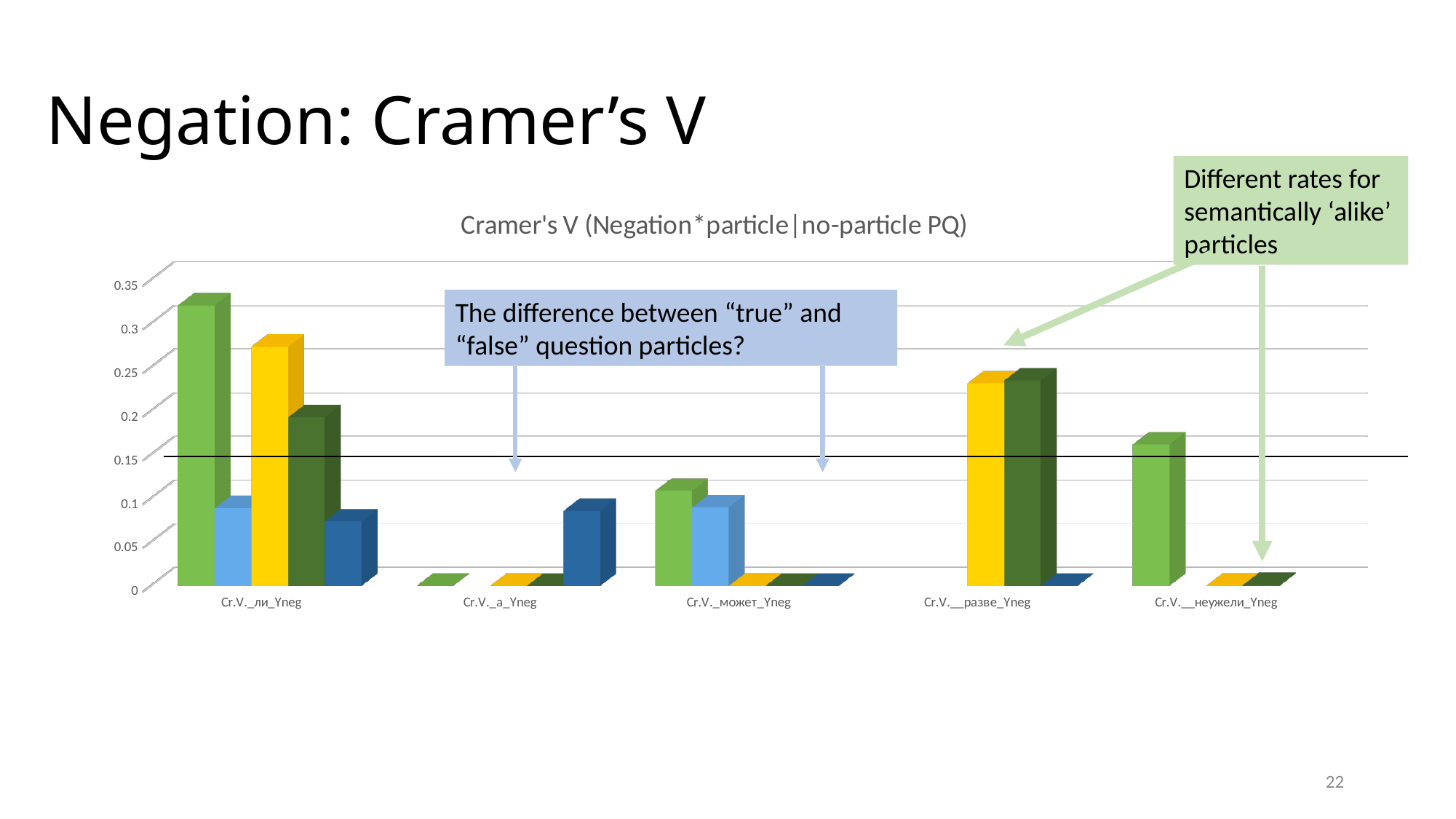
How many categories are shown along the x axis of the chart? 5 What is the highest tick value shown on the vertical axis of the chart? 0.35 What is the title of the chart? Cramer's V (Negation*particle|no-particle PQ) Is the value of the light green bar for Cr.V._ли_Yneg greater or less than 0.3? greater Which category has the tallest bar in the chart? Cr.V._ли_Yneg What kind of chart is shown on the slide? bar chart Is the value of the yellow bar for Cr.V.__разве_Yneg greater or less than 0.2? greater Is the value of the yellow bar for Cr.V._ли_Yneg greater or less than 0.25? greater Which is larger: the light green bar for Cr.V._ли_Yneg or the light green bar for Cr.V.__неужели_Yneg? Cr.V._ли_Yneg